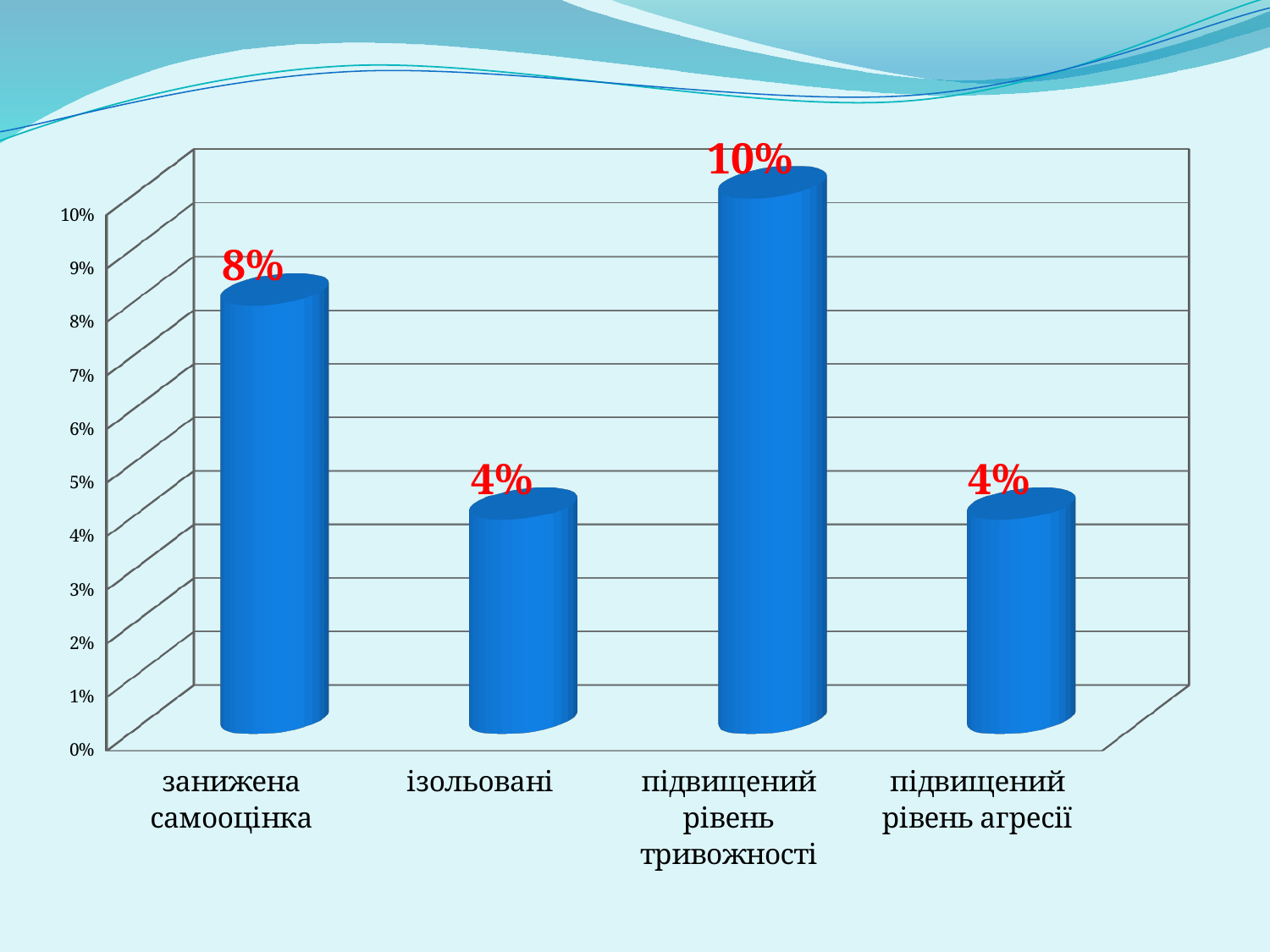
Which is larger, the value for занижена самооцінка or the value for ізольовані? занижена самооцінка What kind of chart is shown on the slide? bar chart What is the value for підвищений рівень агресії? 4% What is the difference between the values for занижена самооцінка and ізольовані? 4% What is the difference between the values for підвищений рівень тривожності and занижена самооцінка? 2% How many categories are shown on the chart? 4 Which category has the highest value? підвищений рівень тривожності What is the value for занижена самооцінка? 8% What colour are the bars on the chart? blue What is the value for підвищений рівень тривожності? 10% What is the value for ізольовані? 4% Is the value for занижена самооцінка greater or less than 5%? greater